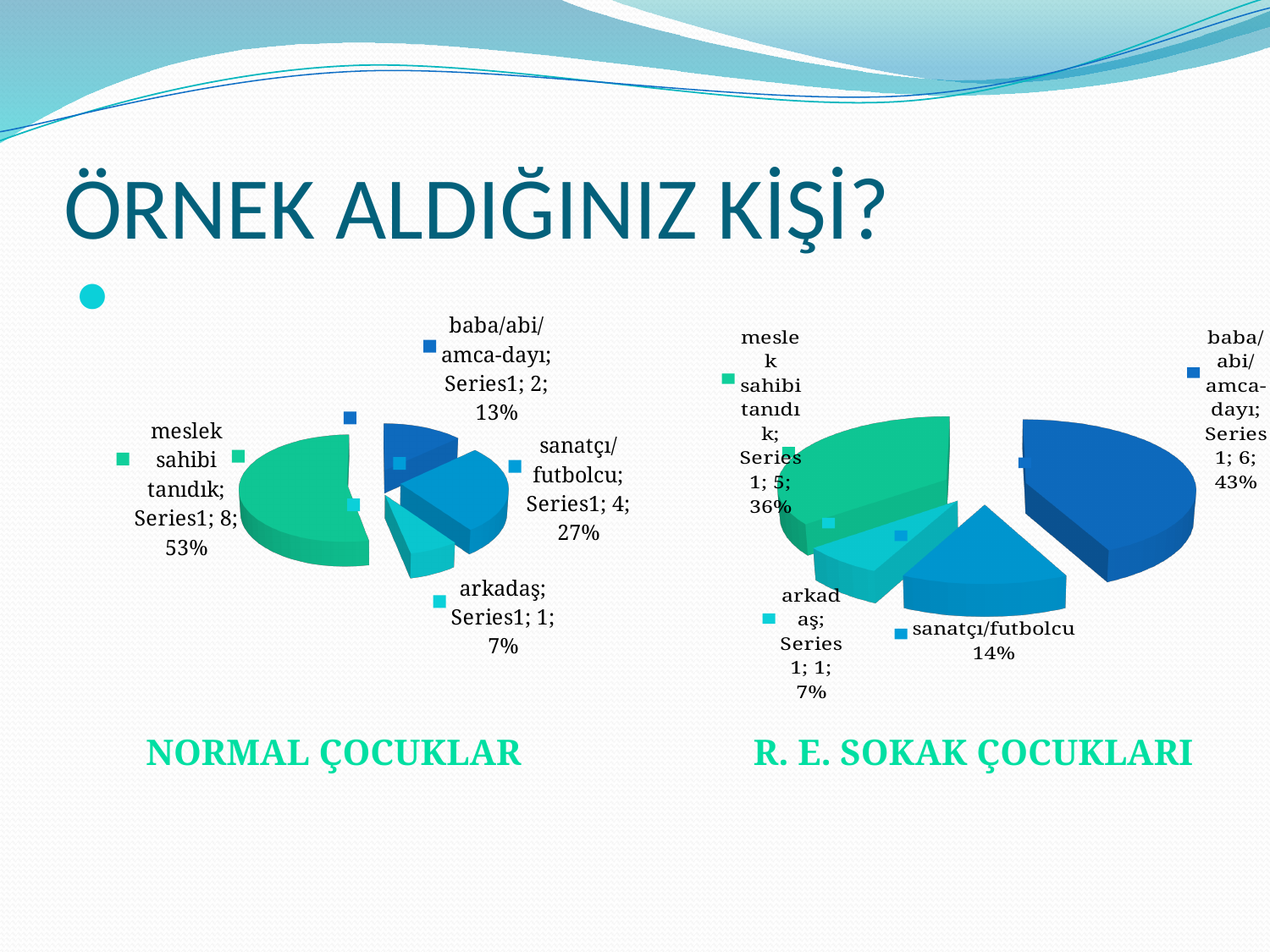
In the R. E. SOKAK ÇOCUKLARI chart, what percentage is shown for sanatçı/futbolcu? 14% What is the title of the slide? ÖRNEK ALDIĞINIZ KİŞİ? In the NORMAL ÇOCUKLAR chart, which category has the smallest share? arkadaş What kind of chart is the R. E. SOKAK ÇOCUKLARI chart? pie chart In the NORMAL ÇOCUKLAR chart, which category has the largest share? meslek sahibi tanıdık In the NORMAL ÇOCUKLAR chart, what is the difference between the values for meslek sahibi tanıdık and sanatçı/futbolcu? 4 How many categories does the NORMAL ÇOCUKLAR chart show? 4 In the NORMAL ÇOCUKLAR chart, what value is shown for sanatçı/futbolcu? 4 In the R. E. SOKAK ÇOCUKLARI chart, which category has the largest share? baba/abi/amca-dayı In the R. E. SOKAK ÇOCUKLARI chart, what percentage is shown for baba/abi/amca-dayı? 43% In the NORMAL ÇOCUKLAR chart, what percentage is shown for meslek sahibi tanıdık? 53% In the R. E. SOKAK ÇOCUKLARI chart, which is larger, the share for meslek sahibi tanıdık or the share for arkadaş? meslek sahibi tanıdık